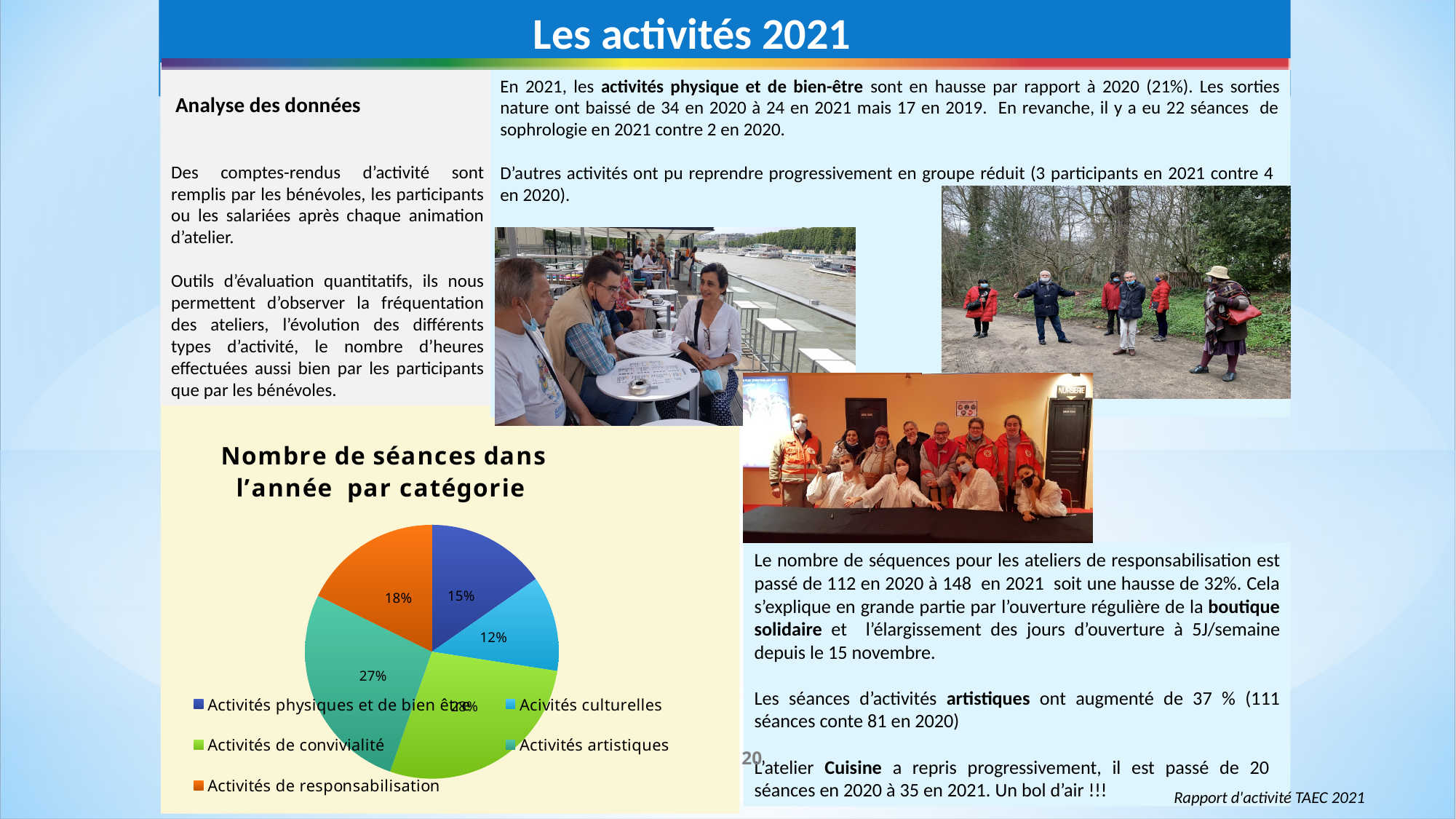
What share of the pie is 'Activités de responsabilisation'? 18% Which category has the smallest share of the pie? Acivités culturelles What is the title of the pie chart? Nombre de séances dans l'année par catégorie What kind of chart is shown on the slide? pie chart Which has the larger share: 'Activités artistiques' or 'Activités de responsabilisation'? Activités artistiques How many categories does the pie chart's legend list? 5 Which has the larger share: 'Activités de responsabilisation' or 'Activités physiques et de bien être'? Activités de responsabilisation What colour represents 'Activités de responsabilisation' in the pie chart? orange By how many percentage points does 'Activités artistiques' exceed 'Acivités culturelles'? 15 What share of the pie is 'Activités physiques et de bien être'? 15% What share of the pie is 'Activités artistiques'? 27% What share of the pie is 'Acivités culturelles'? 12%